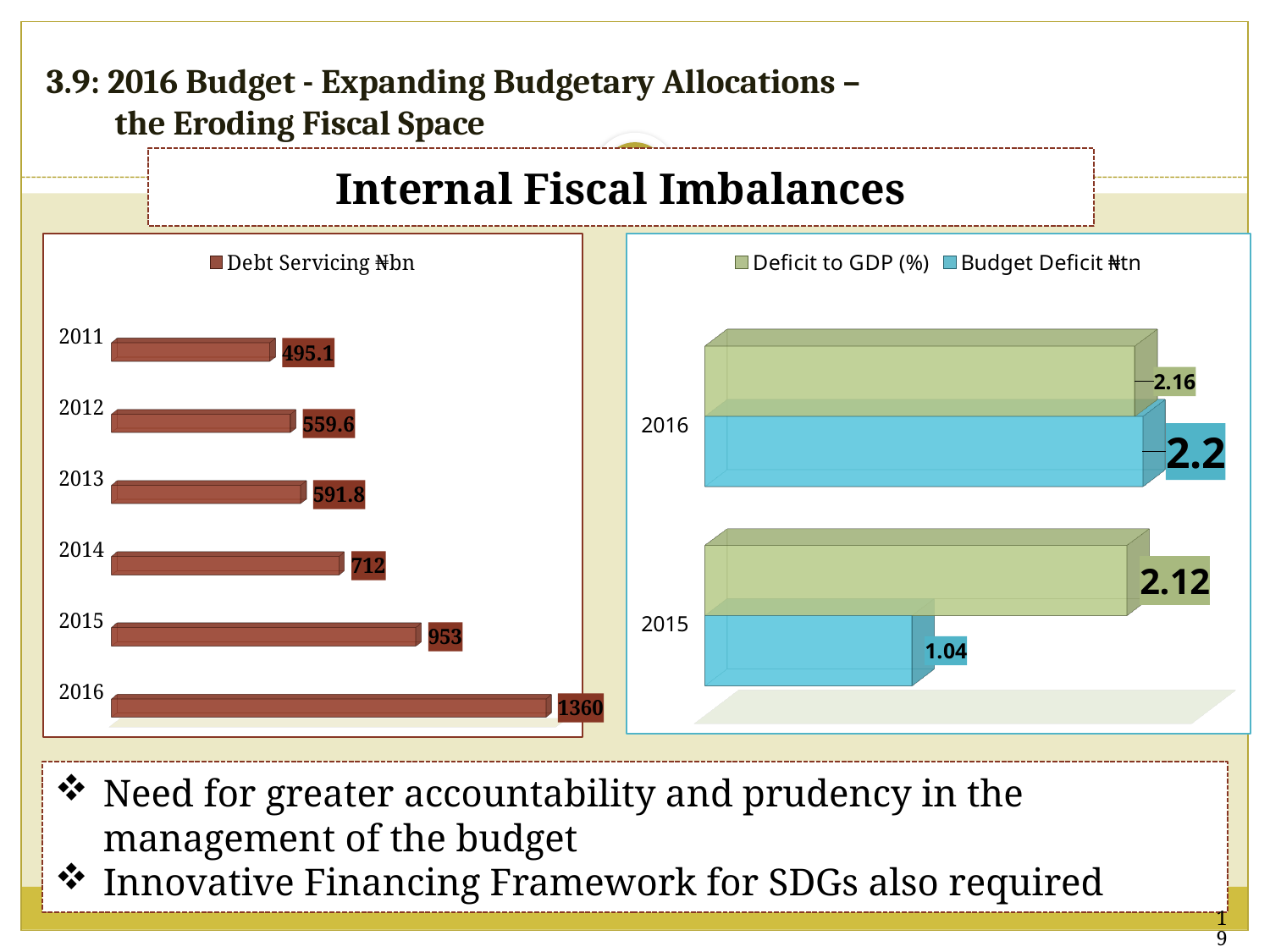
In the left chart (Debt Servicing ₦bn), what is the value for 2016? 1360 In the left chart (Debt Servicing ₦bn), which year has the lowest value? 2011 In the left chart (Debt Servicing ₦bn), what is the difference between the 2016 and 2015 values? 407 In the right chart, what is the Budget Deficit ₦tn value for 2015? 1.04 In the right chart, which is larger: the Budget Deficit ₦tn for 2016 or for 2015? 2016 In the right chart, what is the Deficit to GDP (%) value for 2016? 2.16 In the left chart (Debt Servicing ₦bn), which year has the highest value? 2016 What kind of chart is the left chart (Debt Servicing ₦bn)? bar chart In the left chart (Debt Servicing ₦bn), do the values rise or fall from 2011 to 2016? rise In the left chart (Debt Servicing ₦bn), what is the value for 2011? 495.1 In the left chart (Debt Servicing ₦bn), how many years are shown? 6 How many series does the legend of the right chart list? 2